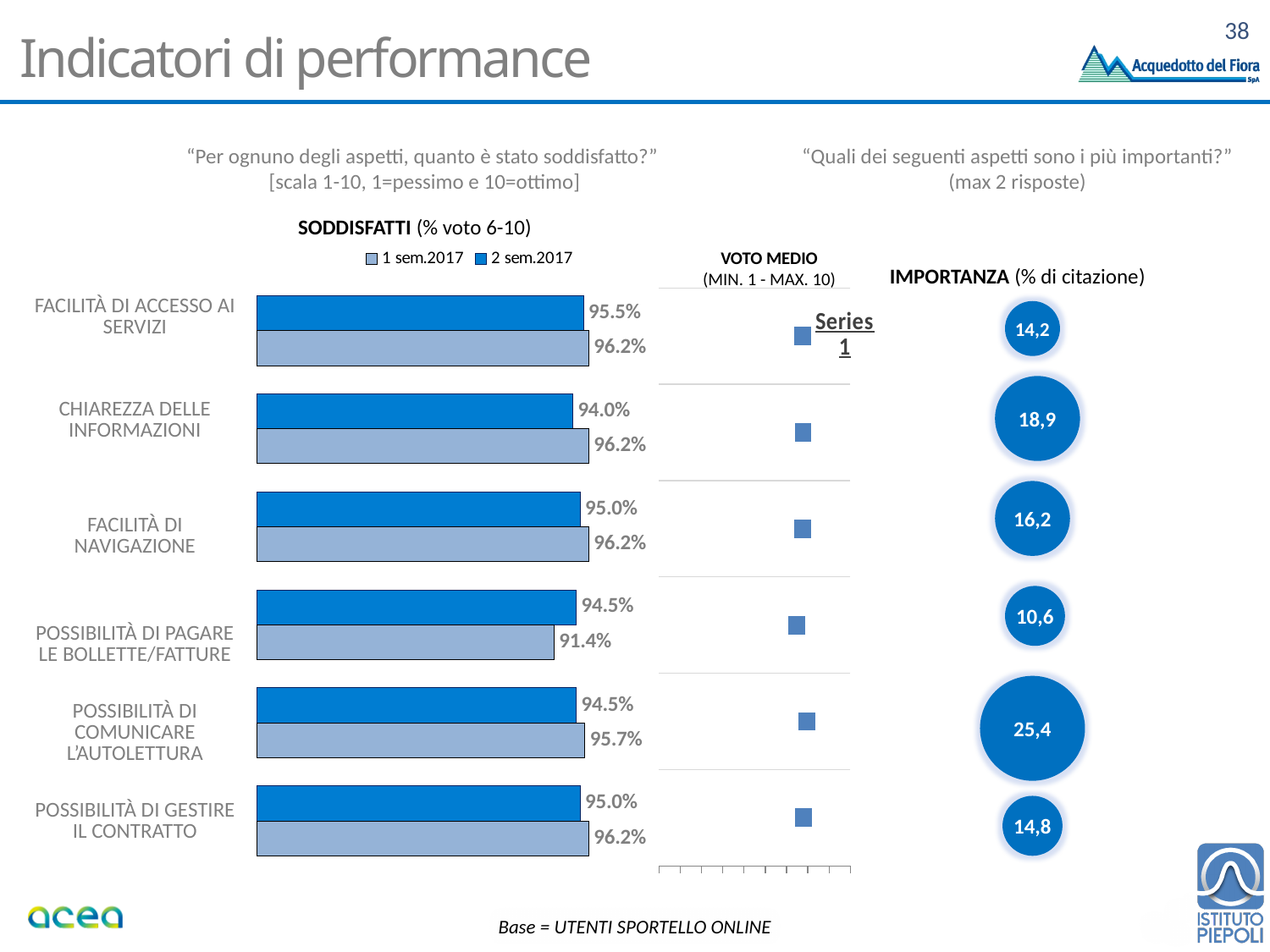
In the SODDISFATTI chart, what is the difference between the 2 sem.2017 and 1 sem.2017 values for CHIAREZZA DELLE INFORMAZIONI? 2.2% In the IMPORTANZA (% di citazione) chart, which aspect has the highest value? POSSIBILITÀ DI COMUNICARE L'AUTOLETTURA In the IMPORTANZA (% di citazione) chart, what is the value for POSSIBILITÀ DI PAGARE LE BOLLETTE/FATTURE? 10,6 In the SODDISFATTI chart, what is the value for 2 sem.2017 for POSSIBILITÀ DI COMUNICARE L'AUTOLETTURA? 95.7% In the SODDISFATTI chart, which category has the highest value for 1 sem.2017? FACILITÀ DI ACCESSO AI SERVIZI How many categories does the SODDISFATTI chart show? 6 In the SODDISFATTI chart, what is the value for 1 sem.2017 for CHIAREZZA DELLE INFORMAZIONI? 94.0% In the SODDISFATTI chart, for POSSIBILITÀ DI PAGARE LE BOLLETTE/FATTURE, which is larger: 1 sem.2017 or 2 sem.2017? 1 sem.2017 What kind of chart is the SODDISFATTI chart? Bar chart In the SODDISFATTI chart, which category has the lowest value for 2 sem.2017? POSSIBILITÀ DI PAGARE LE BOLLETTE/FATTURE How many series does the legend of the SODDISFATTI chart list? 2 In the SODDISFATTI chart, what is the value for 2 sem.2017 for POSSIBILITÀ DI PAGARE LE BOLLETTE/FATTURE? 91.4%